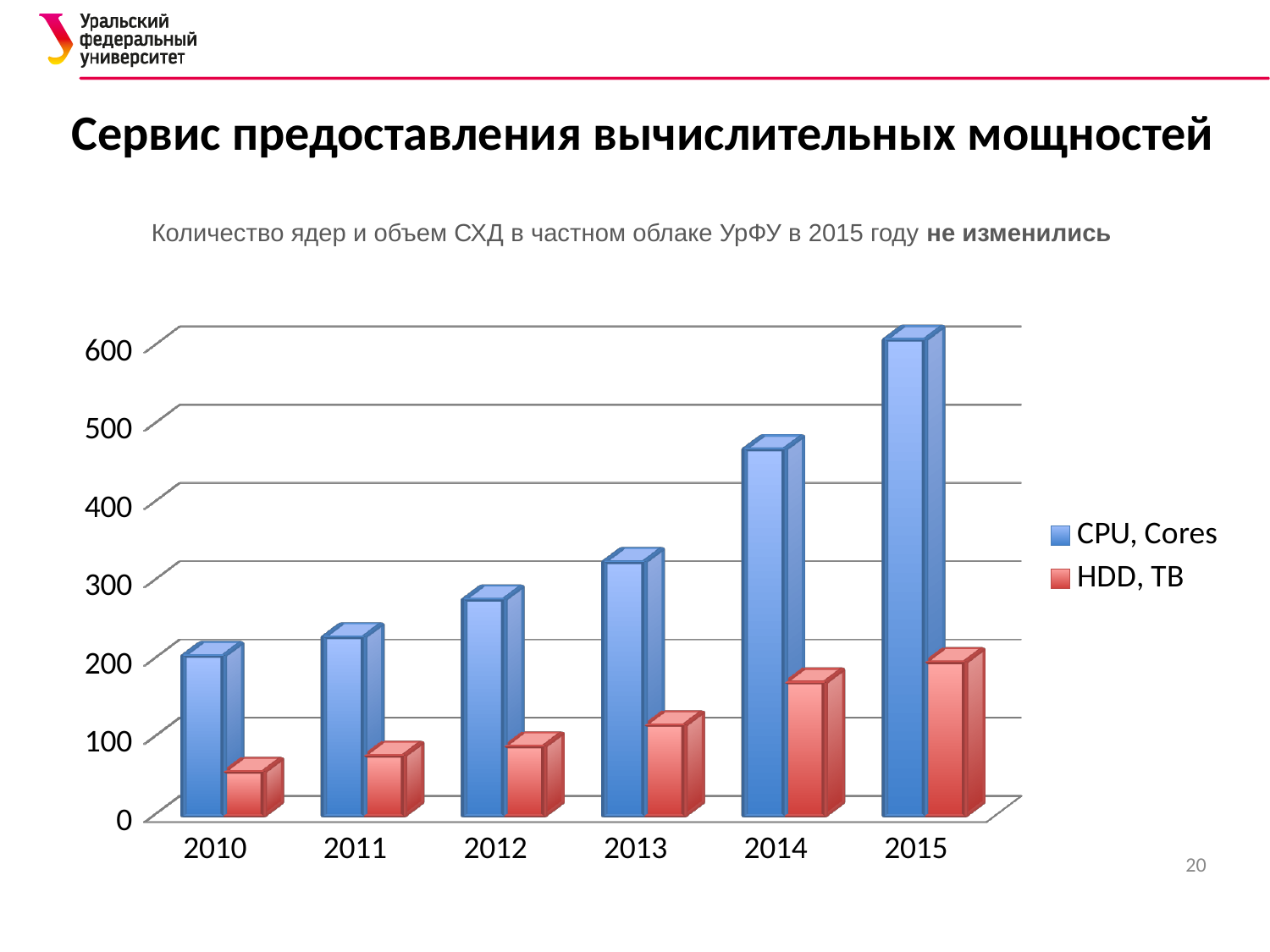
Is the CPU, Cores value for 2012 greater or less than 300? less In which year is the HDD, TB value highest? 2015 In which year is the HDD, TB value lowest? 2010 What kind of chart is shown on the slide? bar chart How many years are shown on the x axis? 6 Is the CPU, Cores value for 2014 greater or less than 400? greater Do the CPU, Cores values rise or fall from 2010 to 2015? rise In which year is the CPU, Cores value highest? 2015 How many series does the legend list? 2 Is the HDD, TB value for 2010 greater or less than 100? less Which is larger: the CPU, Cores value for 2014 or for 2012? 2014